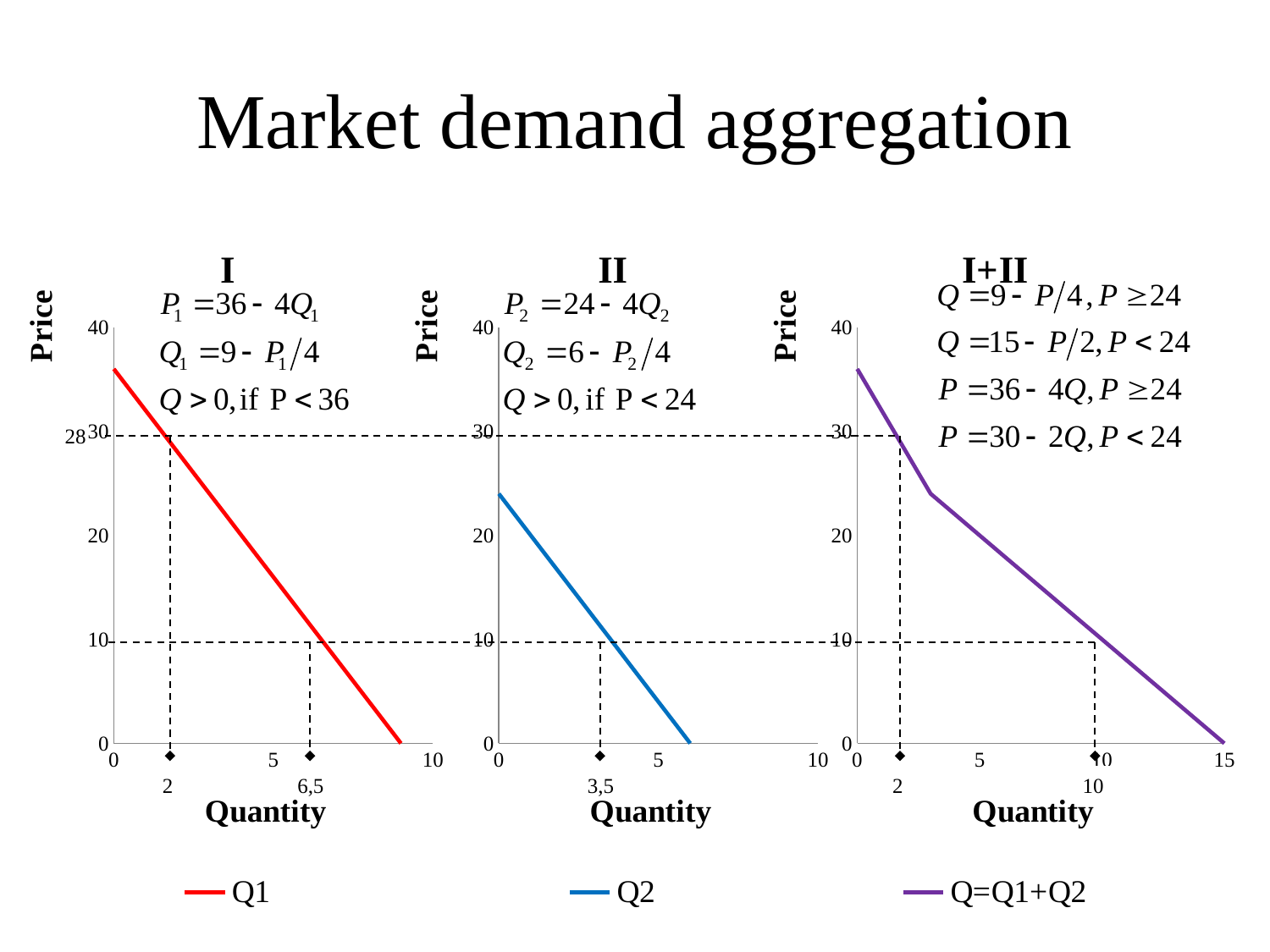
In the chart titled II, what quantity is marked on the x axis at a price of 10? 3,5 What kind of chart is used in the panel titled I? line chart In the chart titled II, is the price at quantity 0 greater or less than 30? less In the chart titled I+II, what quantity is marked on the x axis at a price of 28? 2 How many series does the legend of the chart titled I+II list? 1 What is the legend entry for the line in the chart titled I+II? Q=Q1+Q2 In the chart titled I, is the price at quantity 0 greater or less than 30? greater In the chart titled I+II, does the price rise or fall as quantity increases along the x axis? fall At a price of 10, which chart shows the larger quantity, chart I or chart II? chart I At a price of 10, what is the difference between the quantity in chart I (6,5) and the quantity in chart II (3,5)? 3 In the chart titled I+II, what quantity is marked on the x axis at a price of 10? 10 In the chart titled I, what quantity is marked on the x axis at a price of 10? 6,5